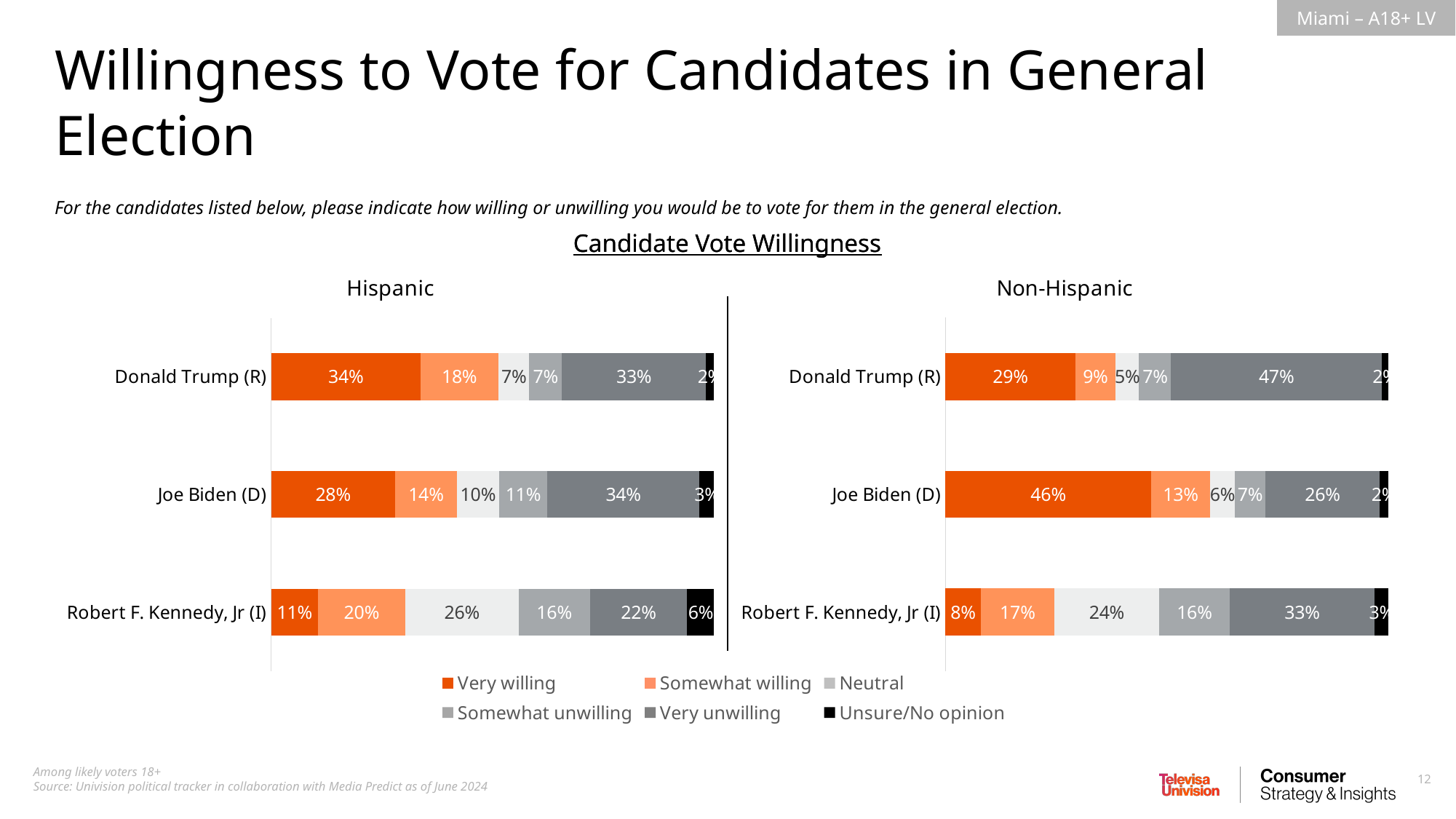
In the Hispanic chart, is the Very unwilling percentage larger for Joe Biden (D) or Robert F. Kennedy, Jr (I)? Joe Biden (D) In the Hispanic chart, what percentage of respondents are very willing to vote for Donald Trump (R)? 34% In the Hispanic chart, what is the Neutral percentage for Robert F. Kennedy, Jr (I)? 26% How many series does the legend list? 6 What type of chart is used for the Non-Hispanic data? Stacked bar chart In the Hispanic chart, which candidate has the highest Very willing percentage? Donald Trump (R) In the Non-Hispanic chart, which candidate has the lowest Very willing percentage? Robert F. Kennedy, Jr (I) In the Hispanic chart, what is the Unsure/No opinion percentage for Robert F. Kennedy, Jr (I)? 6% In the Non-Hispanic chart, what is the difference between the Very willing percentages for Joe Biden (D) and Donald Trump (R)? 17% In the Non-Hispanic chart, what percentage of respondents are very willing to vote for Joe Biden (D)? 46% In the Non-Hispanic chart, what is the Very unwilling percentage for Donald Trump (R)? 47% How many candidates are shown in the Hispanic chart? 3